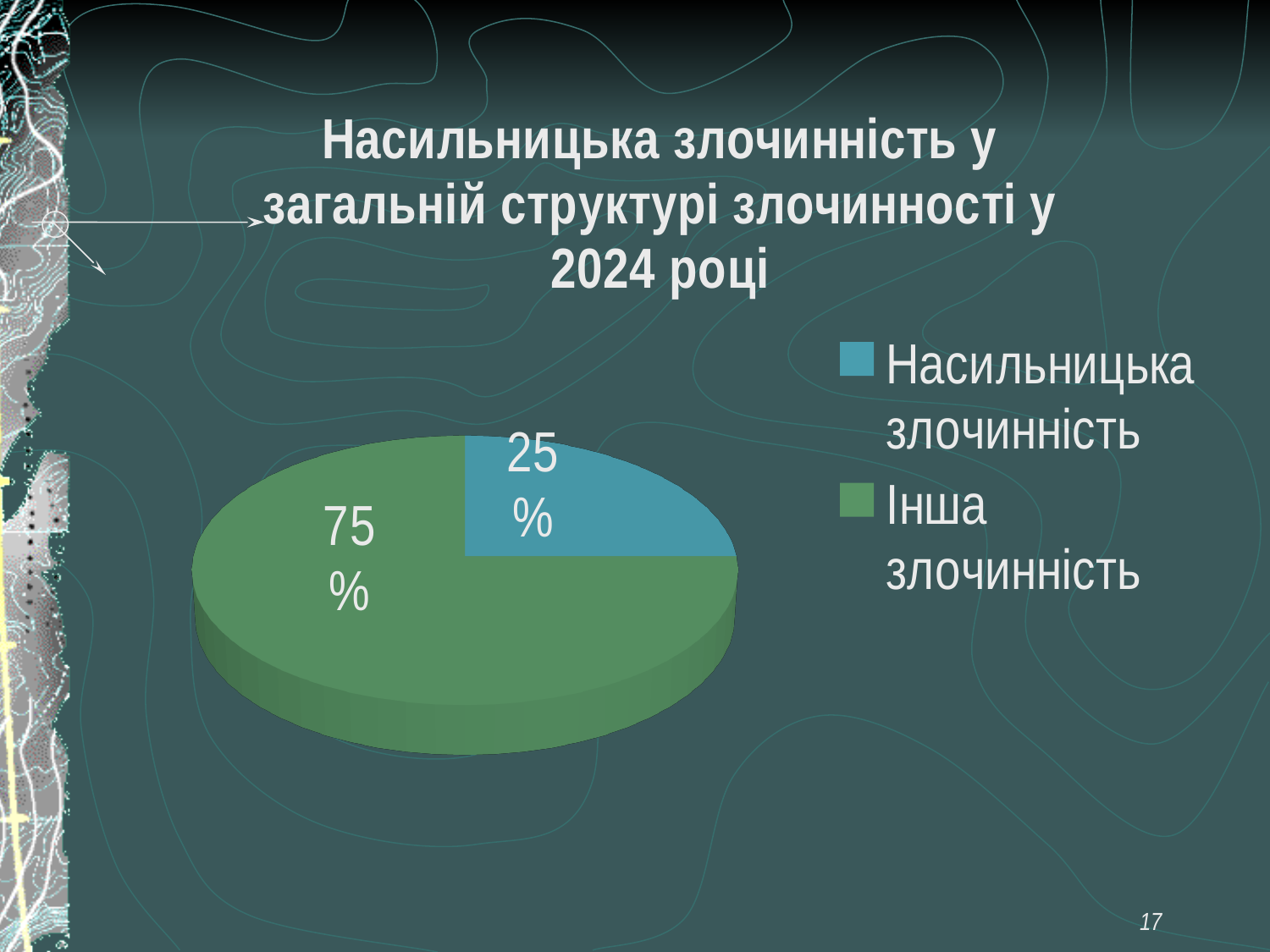
How many entries does the legend list? 2 What is the difference in percentage points between "Інша злочинність" and "Насильницька злочинність"? 50% How many slices does the pie chart have? 2 Which is larger: the slice for "Насильницька злочинність" or the slice for "Інша злочинність"? Інша злочинність What colour is the slice for "Інша злочинність"? Green What share of the pie does "Насильницька злочинність" represent? 25% Which category has the largest slice of the pie? Інша злочинність What share of the pie does "Інша злочинність" represent? 75% What kind of chart is shown on the slide? Pie chart What is the title of the chart? Насильницька злочинність у загальній структурі злочинності у 2024 році Which category has the smallest slice of the pie? Насильницька злочинність